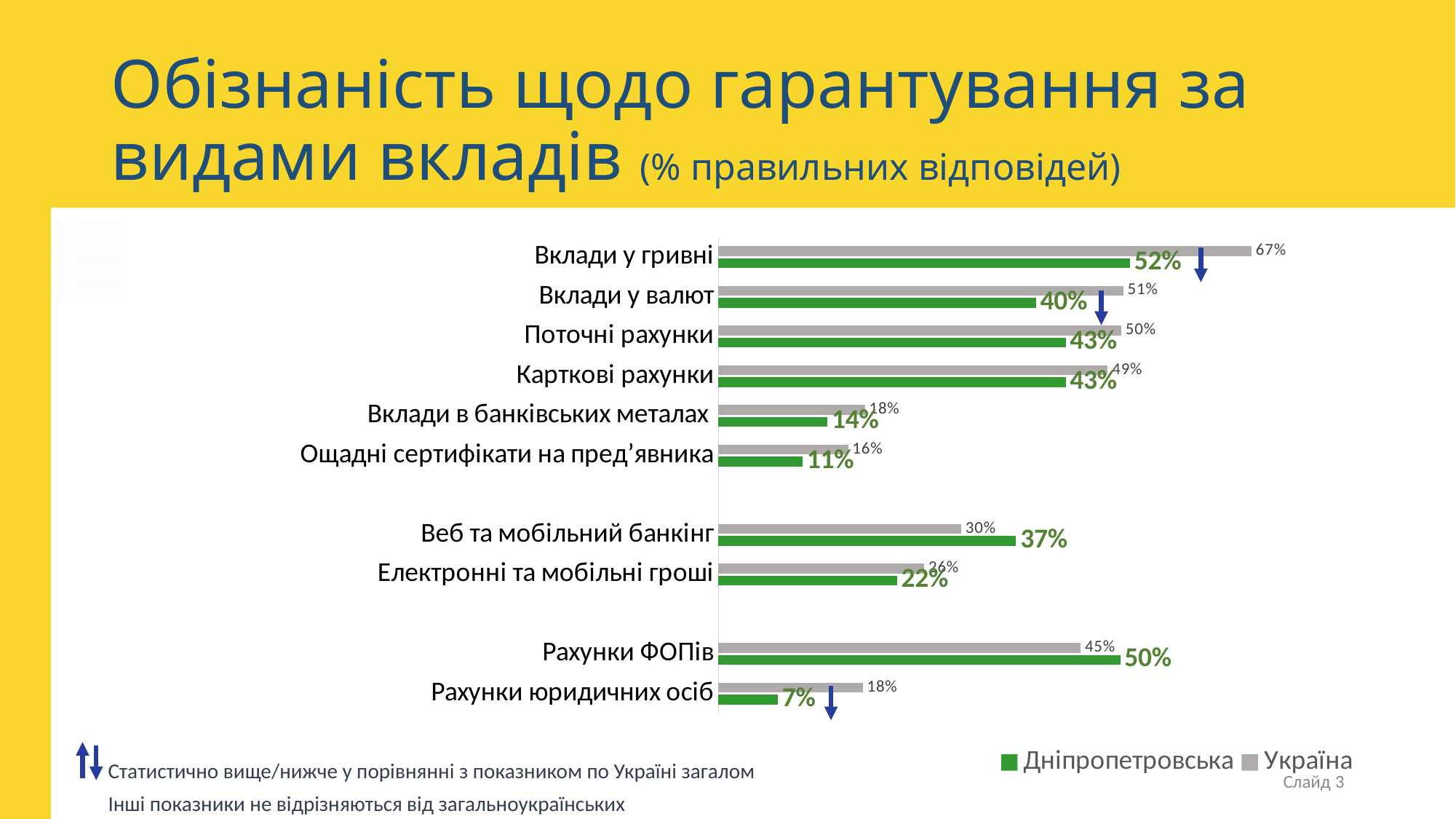
What is the value for Україна for Веб та мобільний банкінг? 30% Which category has the highest value for Дніпропетровська? Вклади у гривні How many categories are shown in the chart? 10 For Рахунки ФОПів, which is larger: the Дніпропетровська value or the Україна value? Дніпропетровська What type of chart is shown on the slide? Bar chart How many series does the legend list? 2 Which colour represents the Україна series in the chart? Grey What is the value for Дніпропетровська for Вклади у гривні? 52% What is the difference between the Україна and Дніпропетровська values for Вклади у гривні? 15% What is the value for Україна for Вклади у гривні? 67% Which category has the lowest value for Дніпропетровська? Рахунки юридичних осіб What is the value for Дніпропетровська for Рахунки юридичних осіб? 7%